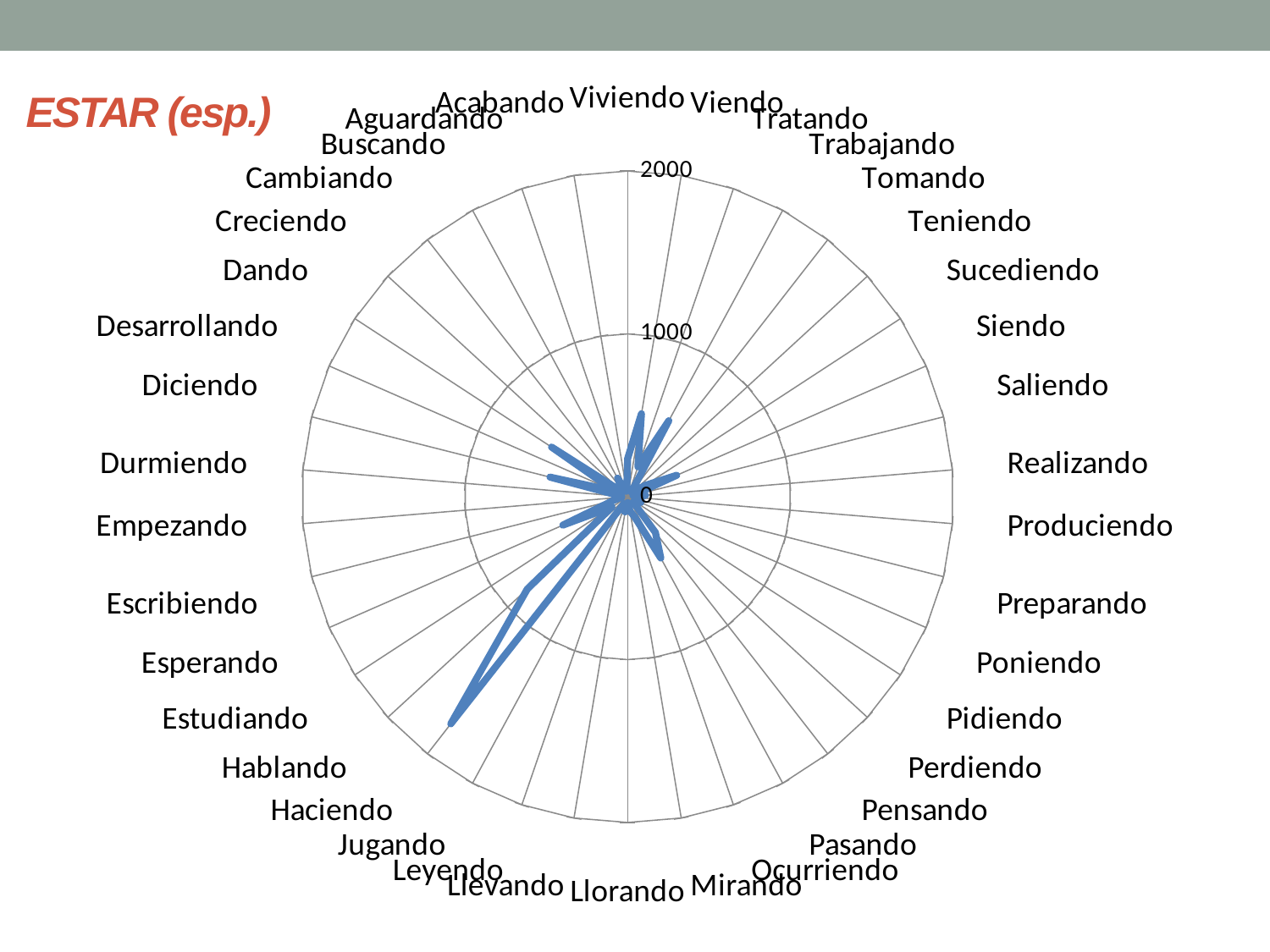
Is the value for Acabando greater or less than 1000? less What is the title shown on the slide for this chart? ESTAR (esp.) Is the largest plotted value on the chart greater or less than 1000? greater Is the largest plotted value on the chart greater or less than 2000? less What is the highest value labelled on the chart's radial axis? 2000 What kind of chart is shown on the slide? radar chart